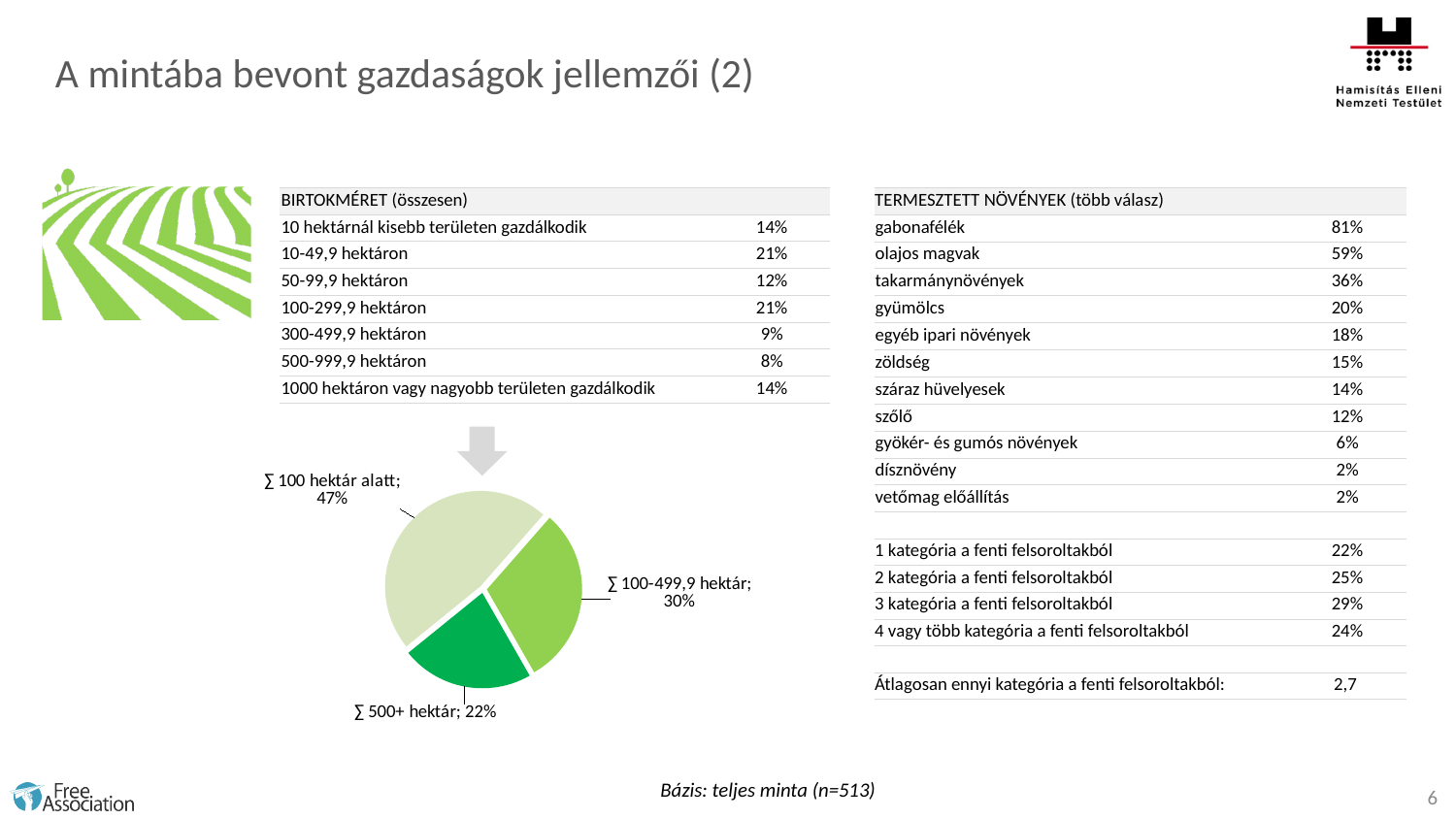
What share of the pie chart does the '∑ 100-499,9 hektár' slice represent? 30% How many slices does the pie chart have? 3 Which slice of the pie chart is the smallest? ∑ 500+ hektár What is the value of the '∑ 100 hektár alatt' slice in the pie chart? 47% Which slice of the pie chart is drawn in the darkest green? ∑ 500+ hektár Which slice of the pie chart is the largest? ∑ 100 hektár alatt In the pie chart, which is larger: the '∑ 100-499,9 hektár' slice or the '∑ 500+ hektár' slice? ∑ 100-499,9 hektár What type of chart is shown on the slide? Pie chart What is the value of the '∑ 100-499,9 hektár' slice in the pie chart? 30% What is the value of the '∑ 500+ hektár' slice in the pie chart? 22% In the pie chart, what is the difference between the '∑ 100-499,9 hektár' slice and the '∑ 500+ hektár' slice? 8% In the pie chart, what is the difference between the '∑ 100 hektár alatt' slice and the '∑ 500+ hektár' slice? 25%